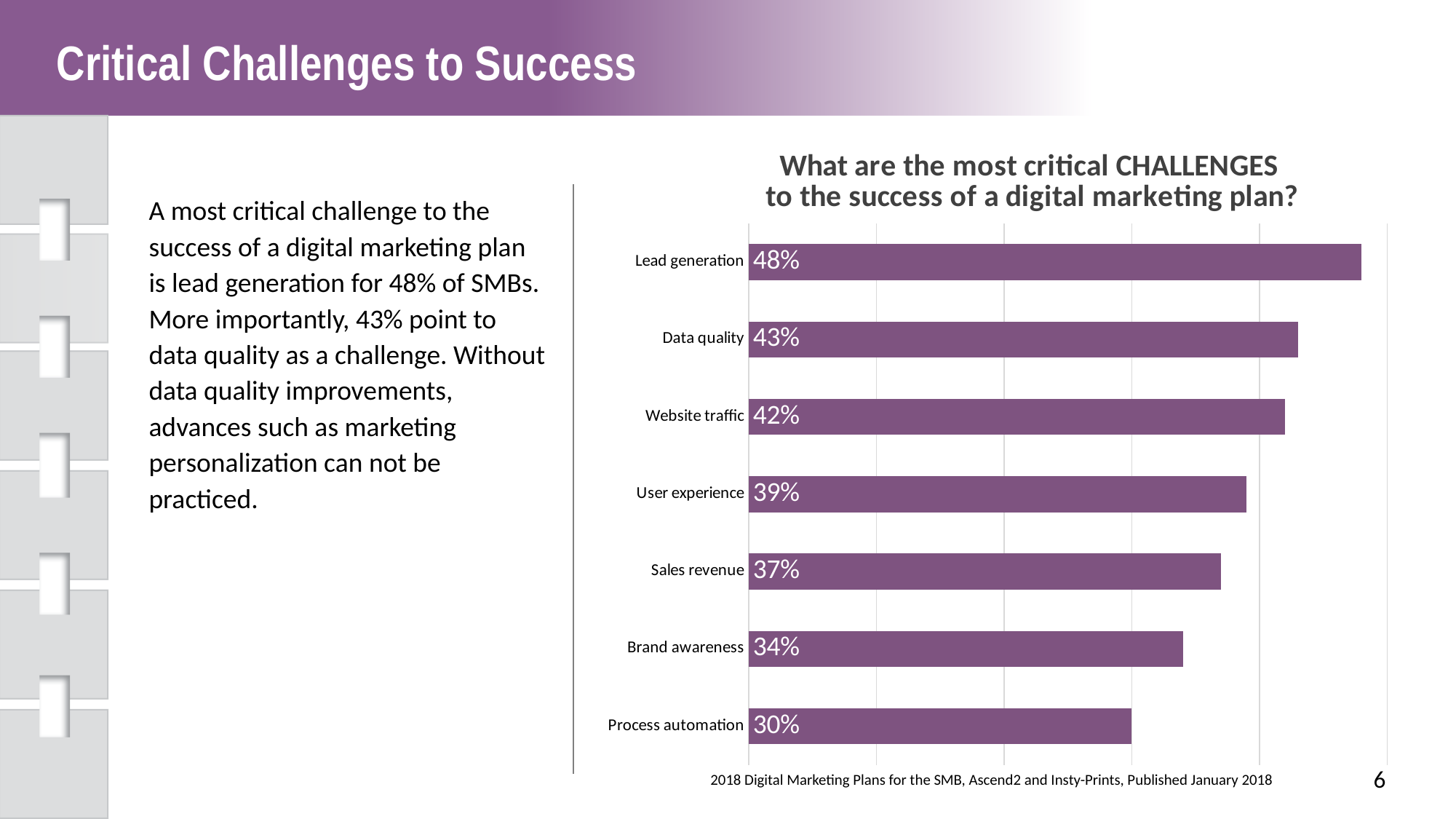
Which challenge has the lowest percentage? Process automation What percentage of respondents cited lead generation as a critical challenge? 48% What is the difference in percentage points between User experience and Process automation? 9 What is the value shown for Brand awareness? 34% How many challenge categories are shown in the chart? 7 What is the difference in percentage points between Lead generation and Data quality? 5 What is the title of the chart? What are the most critical CHALLENGES to the success of a digital marketing plan? Which is larger, the value for Sales revenue or the value for Brand awareness? Sales revenue What is the value shown for Process automation? 30% What is the value shown for Data quality? 43% Which challenge has the highest percentage? Lead generation What type of chart is shown on the slide? Bar chart